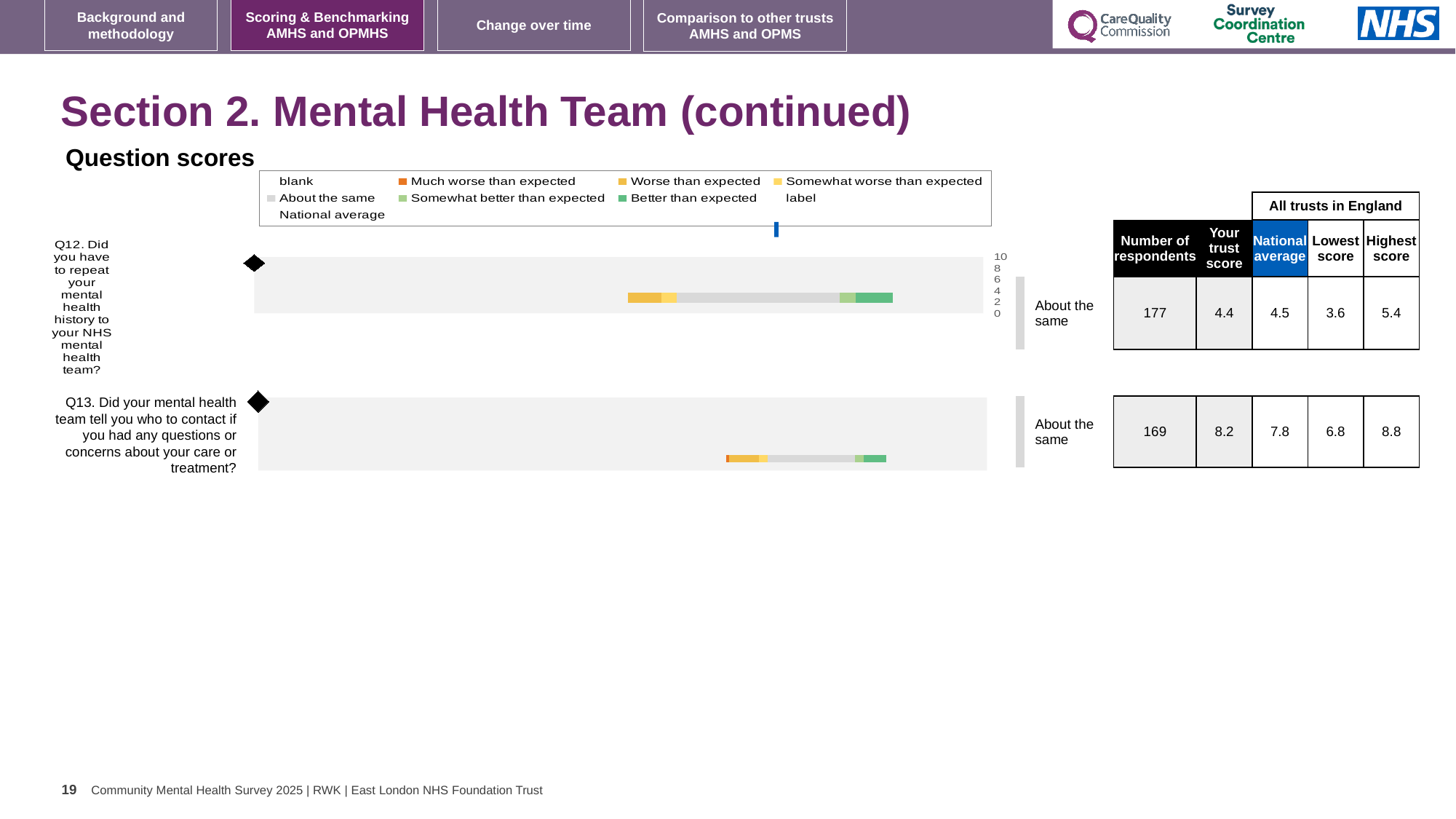
What is the trust score for Q12 (repeating mental health history)? 4.4 What benchmark category is shown for Q13? About the same How many questions are plotted in the question scores chart? 2 What is the national average score for Q12? 4.5 Which question has the higher trust score, Q12 or Q13? Q13 What benchmark category is shown for Q12? About the same What is the difference between the highest score and the lowest score for Q13? 2.0 What is the trust score for Q13 (told who to contact with questions or concerns)? 8.2 What is the difference between the highest score and the lowest score for Q12? 1.8 For Q13, which is larger: the trust score or the national average? the trust score What kind of chart is used to show the question scores for Q12 and Q13? bar chart How many respondents answered Q13? 169